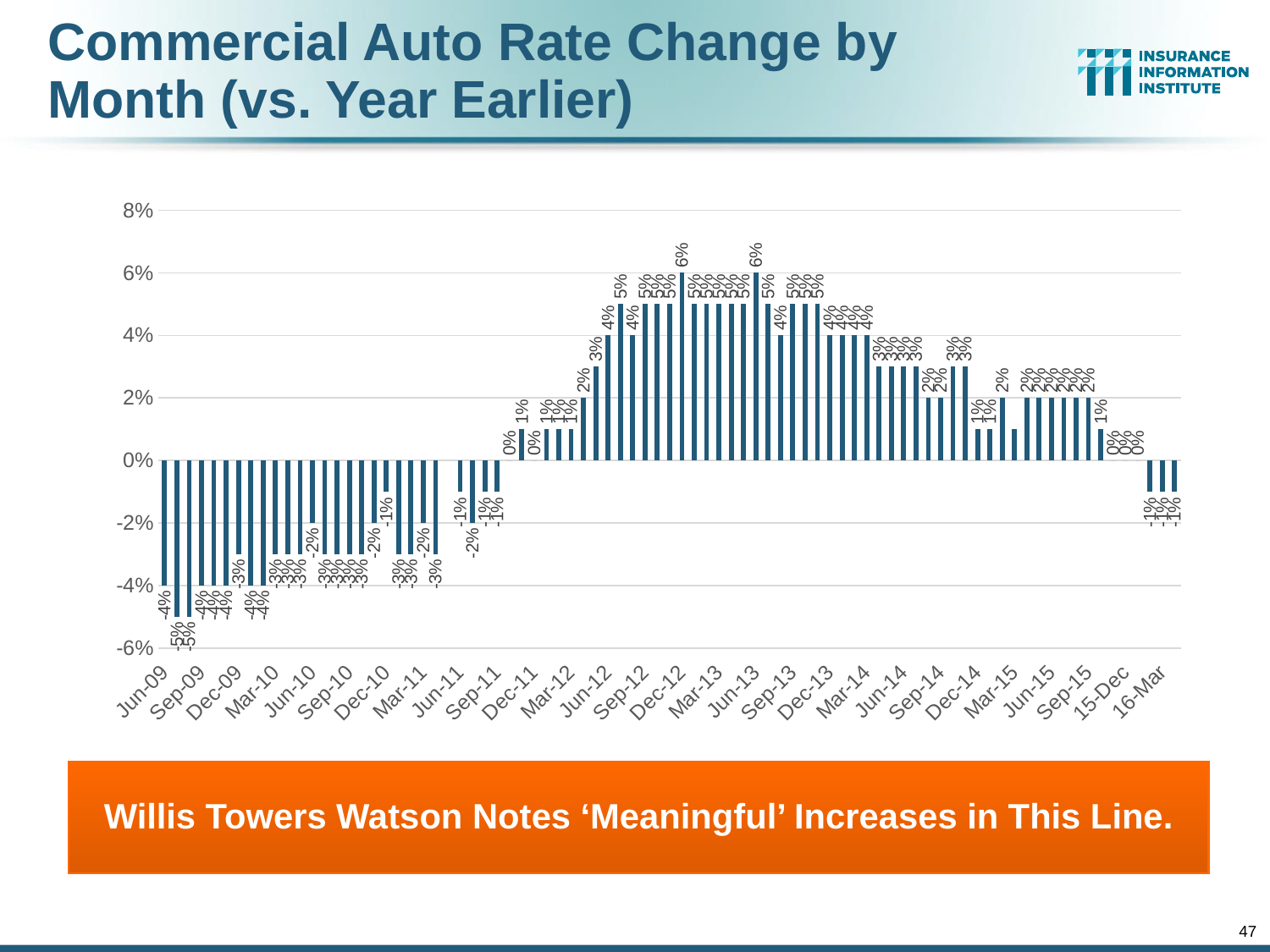
What is the lowest rate change value labeled on the chart? -5% What is the commercial auto rate change for Jun-09, the first month shown? -4% What is the difference in percentage points between the rate change for 16-Mar (-1%) and Jun-09 (-4%)? 3 percentage points Is the rate change for Sep-09 greater or less than -2%? less Is the rate change for Jun-13 greater or less than 4%? greater What is the commercial auto rate change for 16-Mar, the last month shown? -1% Which month has the larger rate change, Jun-09 or Jun-13? Jun-13 Do the rate changes generally rise or fall from Jun-09 to Dec-12? rise What is the highest rate change value labeled on the chart? 6% What kind of chart is shown on the slide? bar chart What is the highest value shown on the vertical axis? 8% What is the title of the chart on the slide? Commercial Auto Rate Change by Month (vs. Year Earlier)